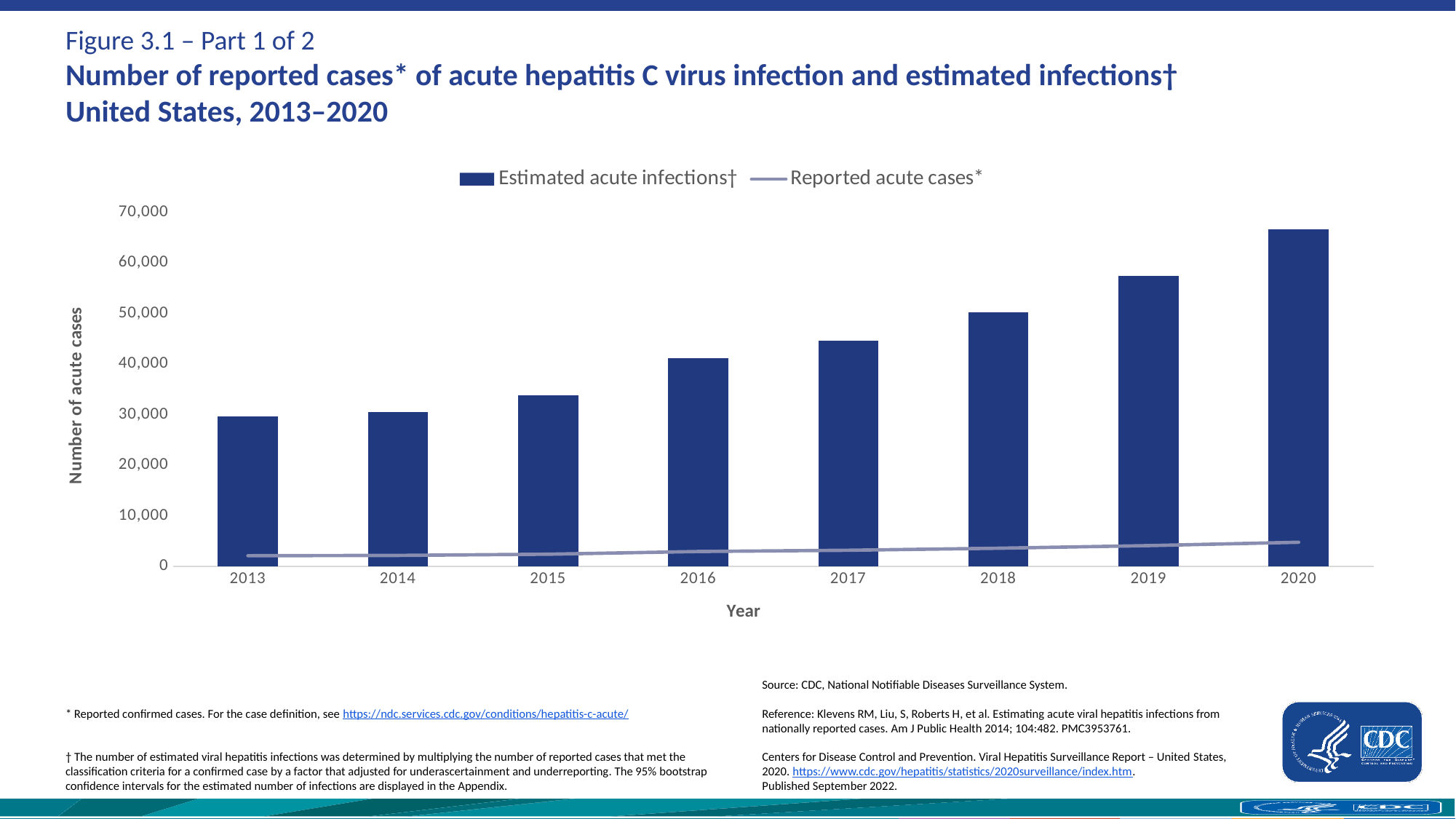
How many series does the legend list? 2 Which year has the lowest number of estimated acute infections? 2013 Is the value for reported acute cases in 2020 greater or less than 10,000? less Which year has the highest number of estimated acute infections? 2020 Is the value for estimated acute infections in 2020 greater or less than 60,000? greater Is the value for estimated acute infections in 2019 greater or less than 50,000? greater Do the estimated acute infections rise or fall from 2013 to 2020? rise Which is larger, the estimated acute infections in 2016 or in 2014? 2016 How many years are shown on the x axis? 8 What kind of chart is shown on the slide? bar chart with a line What is the label of the y axis? Number of acute cases